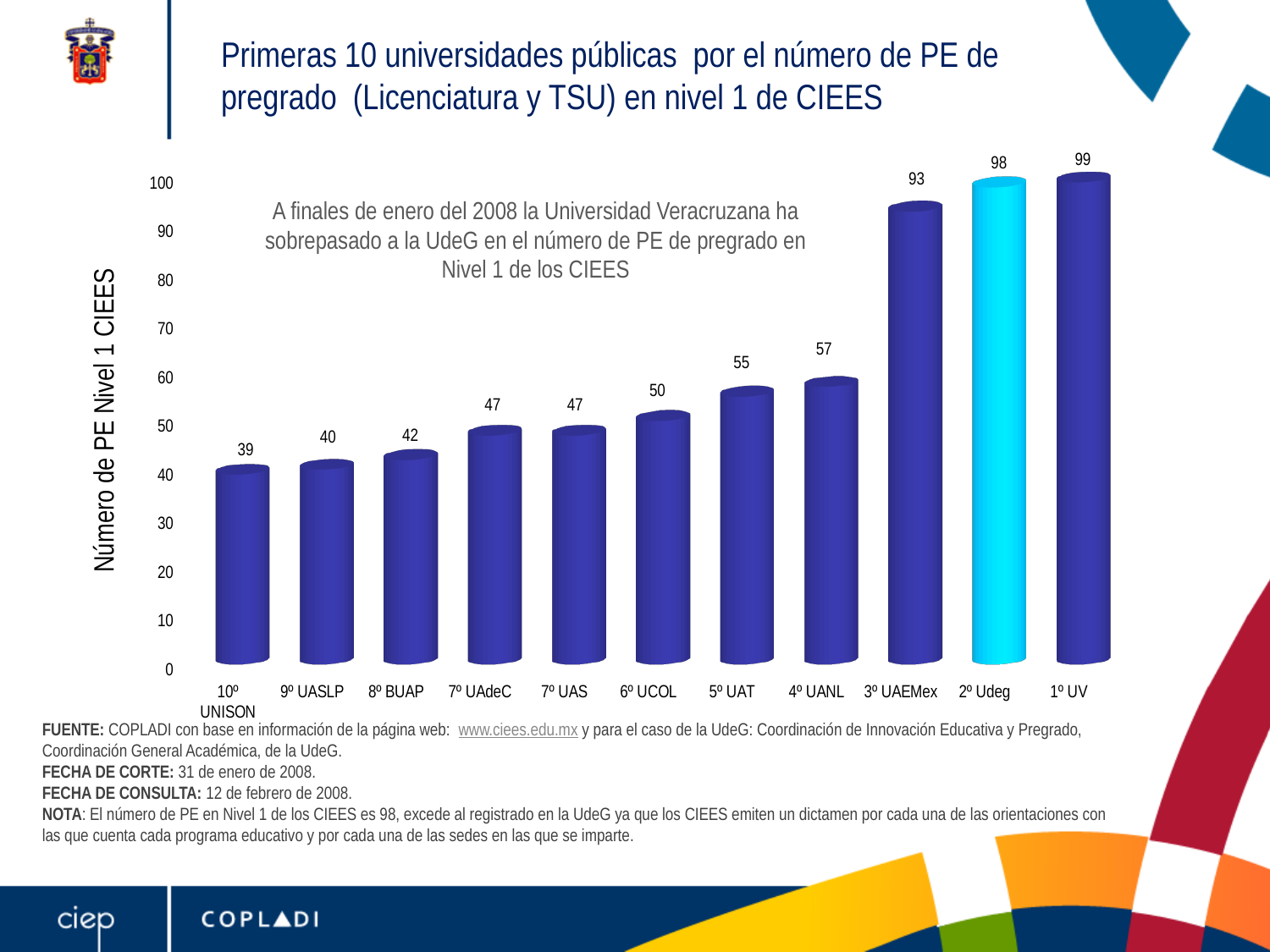
What is the value for 3º UAEMex? 93 What is the difference between the values for 4º UANL and 6º UCOL? 7 What kind of chart is shown on the slide? Bar chart Which university has the lowest number of PE in Nivel 1 CIEES? 10º UNISON What is the value for 10º UNISON? 39 Do the values rise or fall from left to right along the x axis? Rise Which university has the highest number of PE in Nivel 1 CIEES? 1º UV Which is larger, the value for 5º UAT or the value for 8º BUAP? 5º UAT What is the label of the vertical axis? Número de PE Nivel 1 CIEES What is the difference between the values for 1º UV and 2º Udeg? 1 What is the value for 2º Udeg? 98 How many universities are shown in the chart? 11